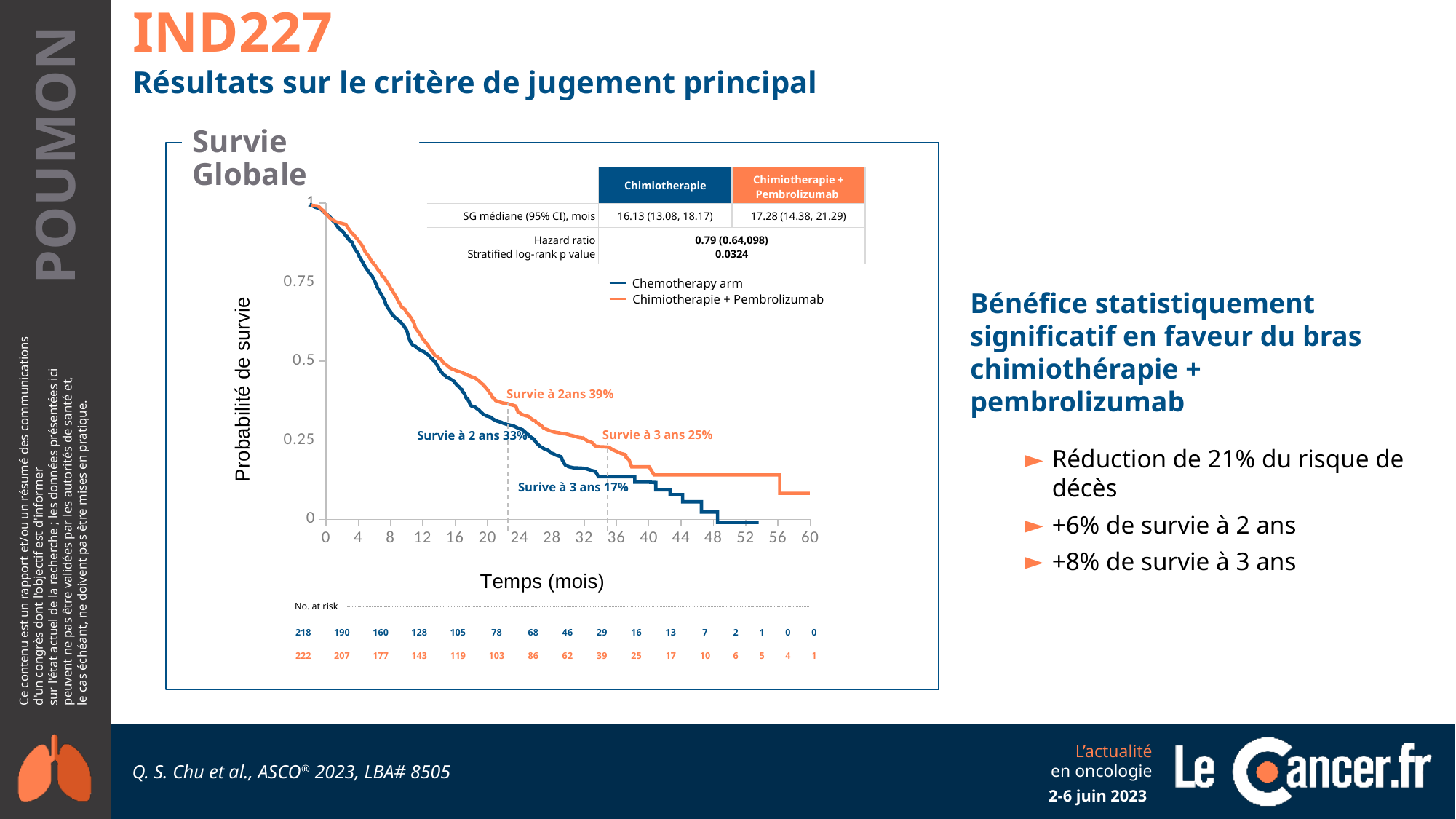
Do the survival curves rise or fall as time increases along the x axis? Fall What is the 3-year survival rate printed for the Chimiotherapie + Pembrolizumab arm? 25% What is the hazard ratio shown in the table? 0.79 What is the median overall survival in months for the Chimiotherapie + Pembrolizumab arm? 17.28 What kind of chart is shown on the slide? Line chart (Kaplan-Meier survival curve) What is the label of the x axis? Temps (mois) What is the 2-year survival rate printed for the Chimiotherapie + Pembrolizumab arm? 39% Which arm has the higher 2-year survival rate? Chimiotherapie + Pembrolizumab What is the difference in 3-year survival between the Chimiotherapie + Pembrolizumab arm and the chemotherapy arm? 8% What is the 2-year survival rate printed for the chemotherapy arm? 33% What is the 3-year survival rate printed for the chemotherapy arm? 17% How many series does the legend list? 2